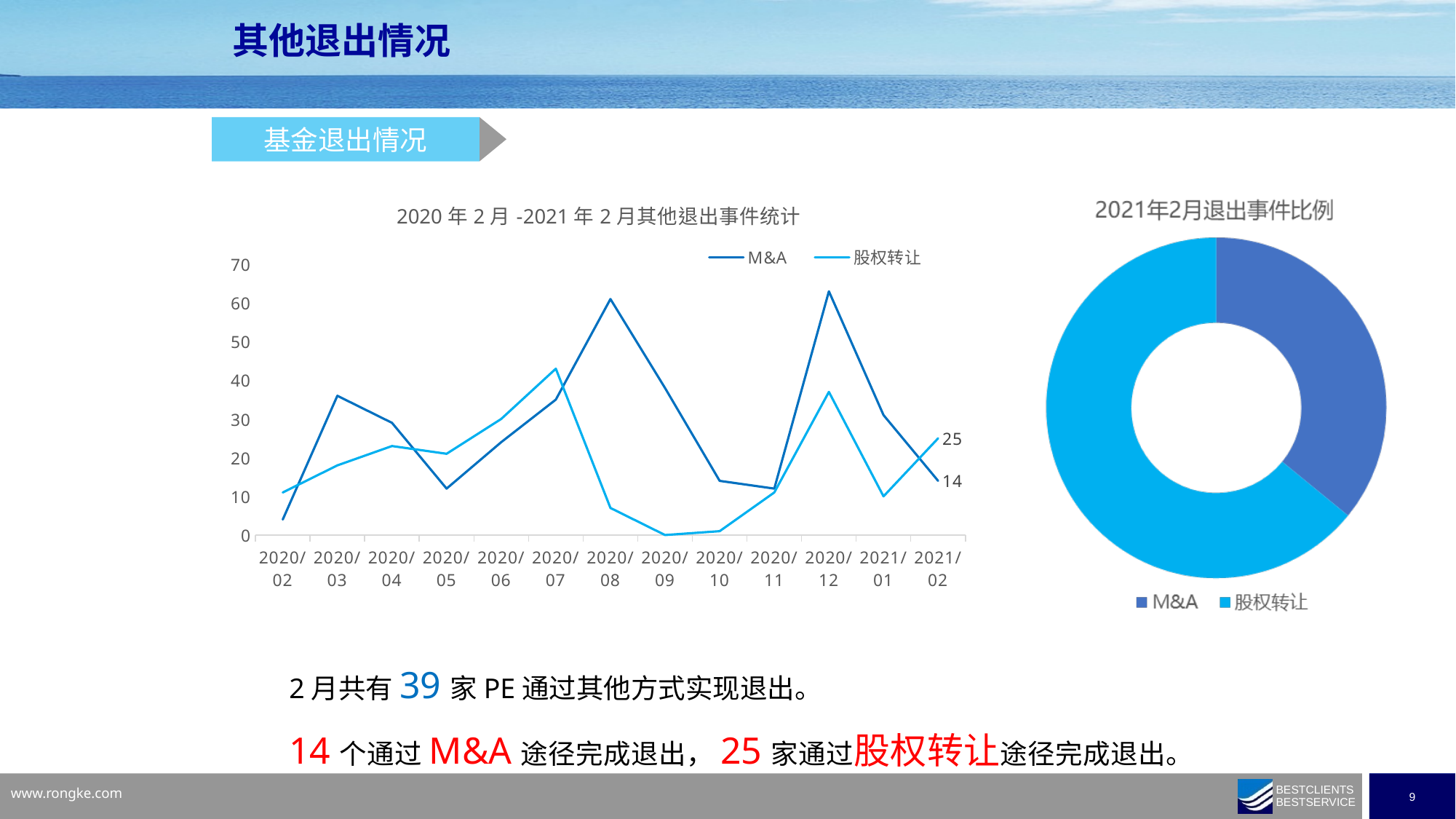
In the line chart '2020年2月-2021年2月其他退出事件统计', is the value for M&A at 2020/08 greater or less than 50? greater How many months are plotted on the x axis of the line chart '2020年2月-2021年2月其他退出事件统计'? 13 In the line chart '2020年2月-2021年2月其他退出事件统计', what is the difference between 股权转让 and M&A at 2021/02? 11 What kind of chart is the chart titled '2021年2月退出事件比例'? Doughnut (pie) chart How many series does the legend of the line chart '2020年2月-2021年2月其他退出事件统计' list? 2 In the line chart '2020年2月-2021年2月其他退出事件统计', which series has the larger value at 2021/02? 股权转让 In the line chart '2020年2月-2021年2月其他退出事件统计', what is the value for M&A at 2021/02? 14 In the line chart '2020年2月-2021年2月其他退出事件统计', in which month does 股权转让 reach its highest value? 2020/07 In the line chart '2020年2月-2021年2月其他退出事件统计', is the value for 股权转让 at 2020/09 greater or less than 10? less In the chart '2021年2月退出事件比例', which category has the larger share? 股权转让 In the line chart '2020年2月-2021年2月其他退出事件统计', what is the value for 股权转让 at 2021/02? 25 In the line chart '2020年2月-2021年2月其他退出事件统计', in which month does M&A have its lowest value? 2020/02